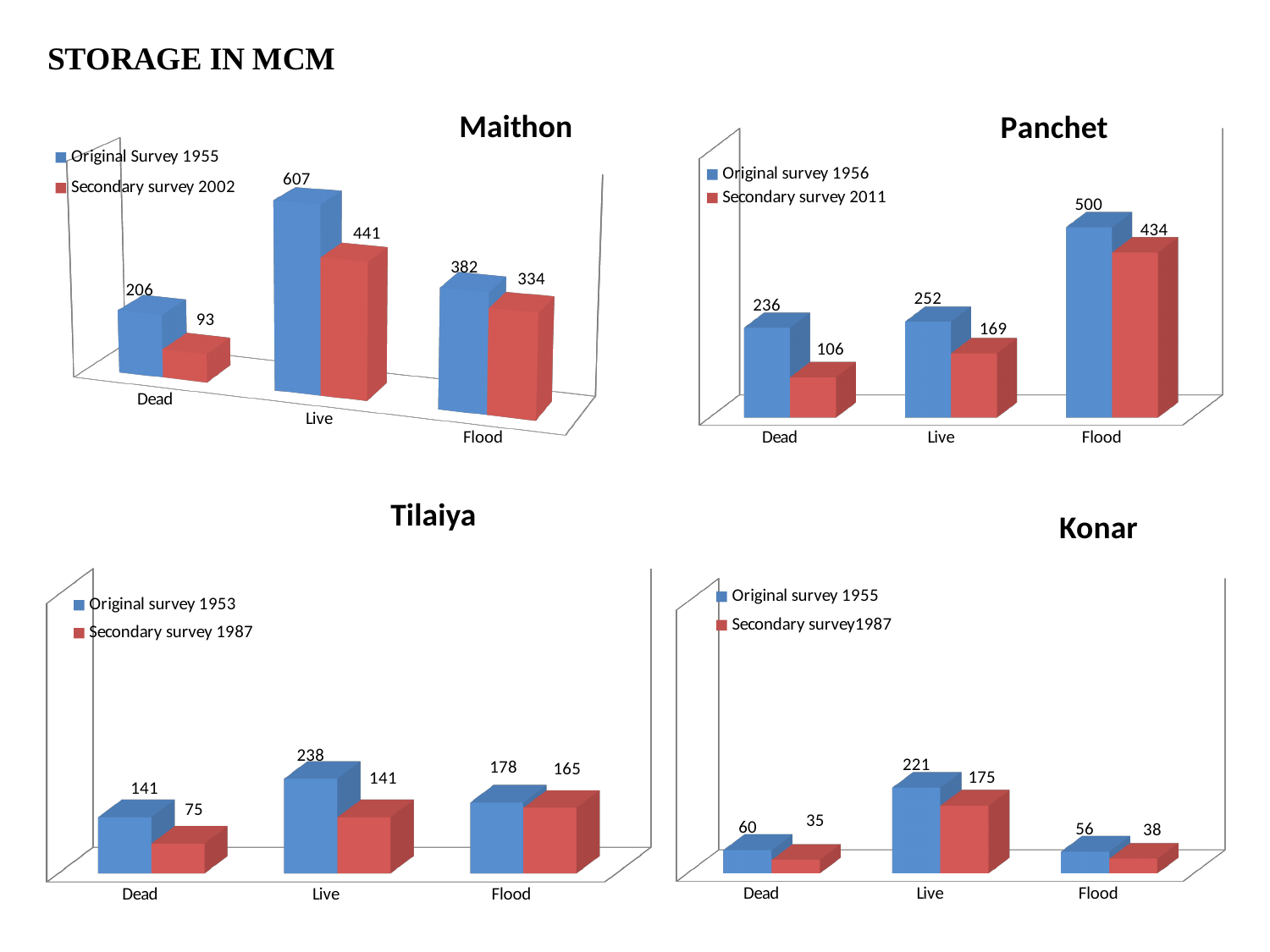
In the Konar chart, which category has the highest value in the Original survey 1955 series? Live In the Panchet chart, what is the difference between the Original survey 1956 and Secondary survey 2011 values for Flood? 66 In the Tilaiya chart, what is the value for Flood in the Secondary survey 1987 series? 165 In the Konar chart, what is the difference between the Original survey 1955 and Secondary survey1987 values for Dead? 25 What is the title of the chart in the bottom-left of the slide? Tilaiya In the Tilaiya chart, which is larger: the Original survey 1953 value for Live or the Original survey 1953 value for Flood? Live How many categories are shown on the x axis of the Konar chart? 3 In the Maithon chart, what is the value for Live in the Original Survey 1955 series? 607 In the Maithon chart, which category has the lowest value in the Secondary survey 2002 series? Dead What kind of chart is the Maithon chart? Bar chart How many series does the legend of the Panchet chart list? 2 In the Panchet chart, what is the value for Dead in the Secondary survey 2011 series? 106